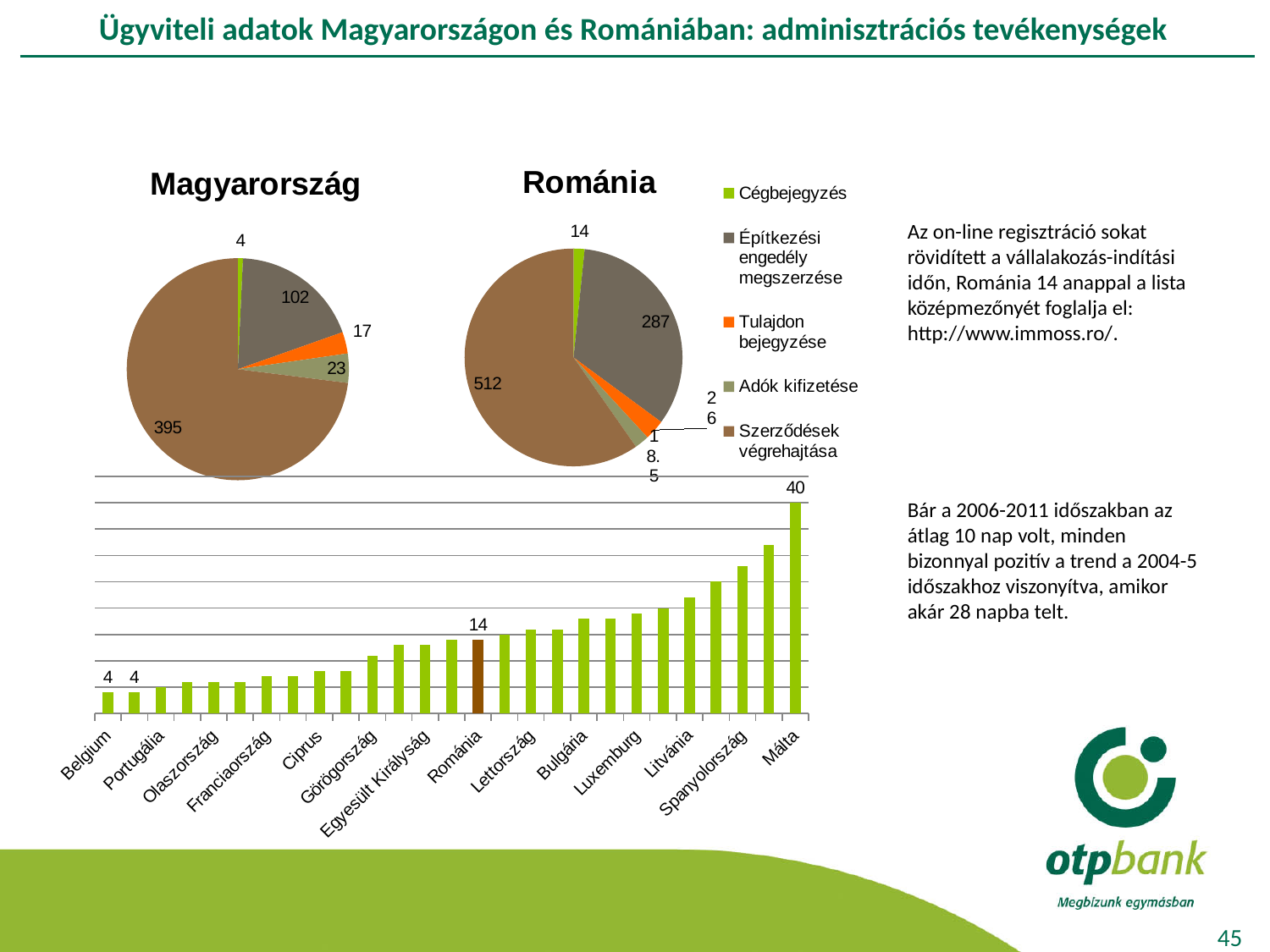
In the Románia pie chart, what is the value for Építkezési engedély megszerzése? 287 In the bar chart at the bottom of the slide, what is the value for Málta? 40 In the Magyarország pie chart, what is the value for Szerződések végrehajtása? 395 In the bar chart at the bottom of the slide, which country has the highest value? Málta In the bar chart at the bottom of the slide, do the values rise or fall from left to right? rise In the Románia pie chart, what is the value for Szerződések végrehajtása? 512 In the Magyarország pie chart, what is the value for Építkezési engedély megszerzése? 102 In the Magyarország pie chart, which category has the largest slice? Szerződések végrehajtása In the bar chart at the bottom of the slide, what is the value for Románia? 14 In the Magyarország pie chart, what is the value for Cégbejegyzés? 4 In the Magyarország pie chart, what is the difference between Adók kifizetése and Tulajdon bejegyzése? 6 How many series does the legend next to the pie charts list? 5